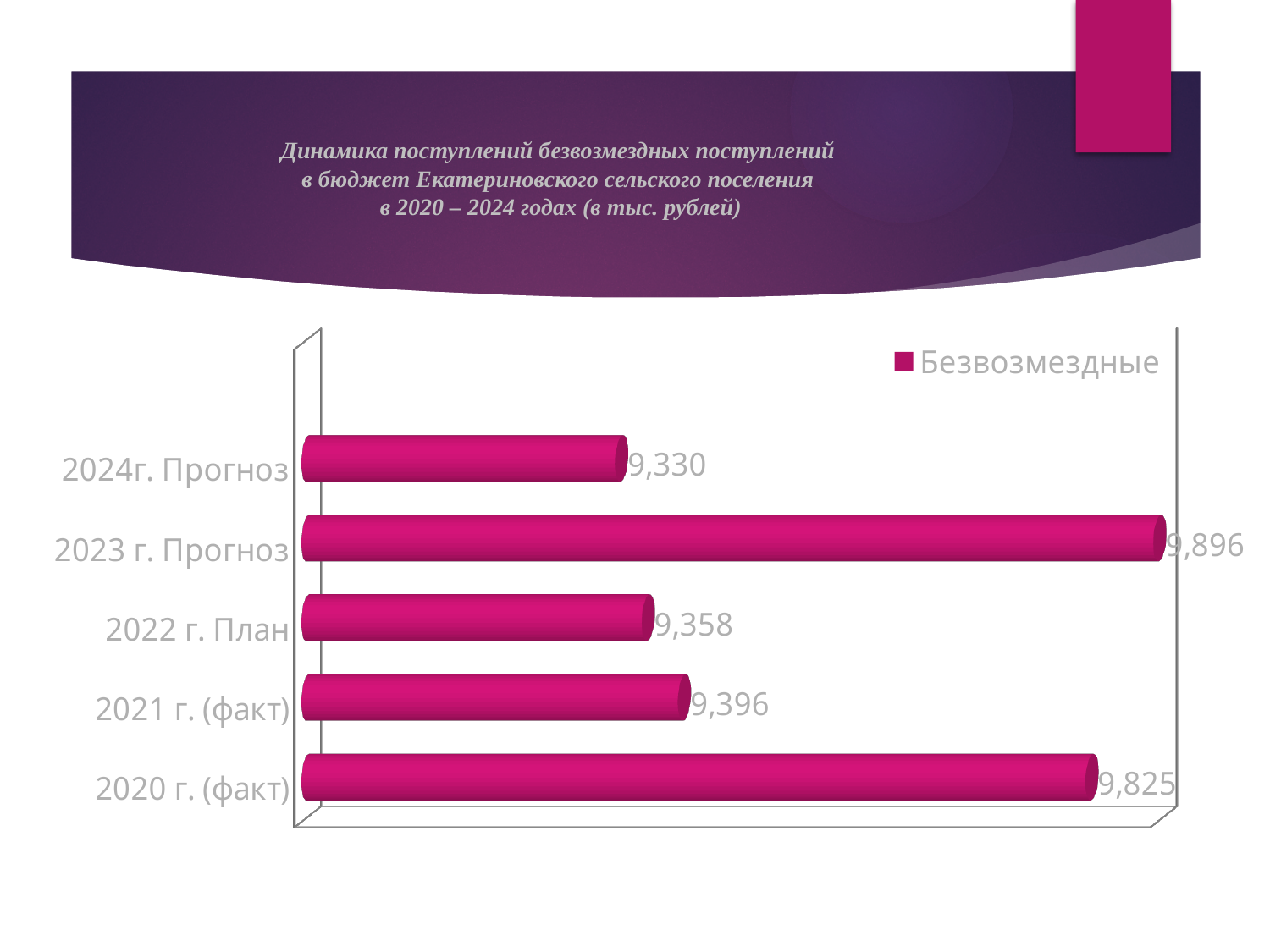
Which category has the highest value? 2023 г. Прогноз What is the value for 2022 г. План? 9,358 How many categories are shown in the chart? 5 What is the value for 2023 г. Прогноз? 9,896 What is the value for 2021 г. (факт)? 9,396 How many series does the legend list? 1 Which is larger, the value for 2020 г. (факт) or the value for 2021 г. (факт)? 2020 г. (факт) What is the value for 2020 г. (факт)? 9,825 What is the name of the series shown in the legend? Безвозмездные What is the value for 2024г. Прогноз? 9,330 What kind of chart is shown on the slide? bar chart Which category has the lowest value? 2024г. Прогноз